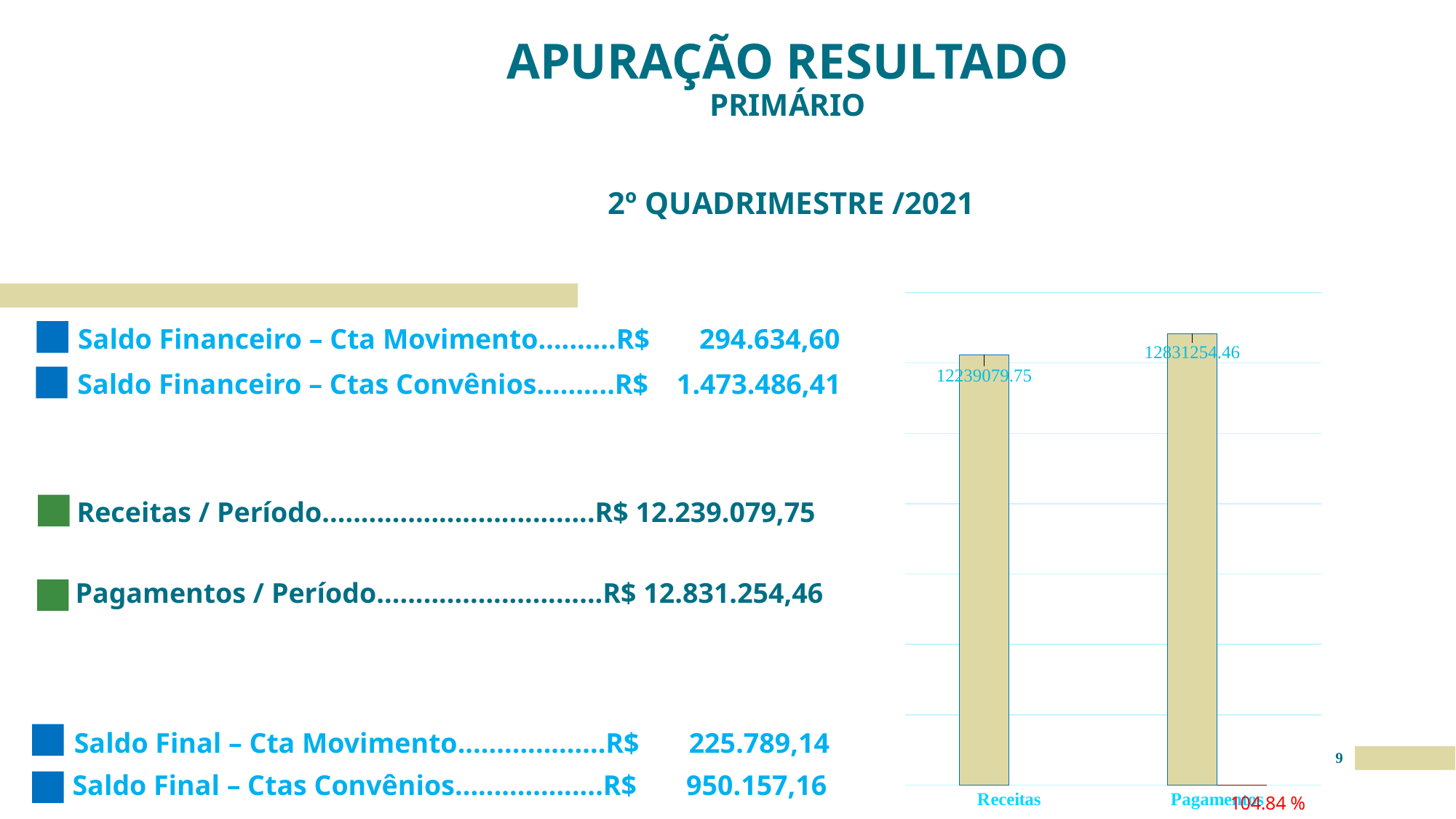
Do the bar values rise or fall from Receitas to Pagamentos? rise What is the value of the Pagamentos bar in the chart? 12831254.46 What is the difference between the Pagamentos value and the Receitas value in the chart? 592174.71 What are the two category labels on the x axis of the chart? Receitas and Pagamentos What percentage is printed in red at the bottom right of the chart? 104.84 % What is the value of the Receitas bar in the chart? 12239079.75 Is the bar for Pagamentos larger or smaller than the bar for Receitas? larger What type of chart is shown on the slide? bar chart Which category has the lowest bar in the chart? Receitas Which category has the highest bar in the chart? Pagamentos How many bars are plotted in the chart? 2